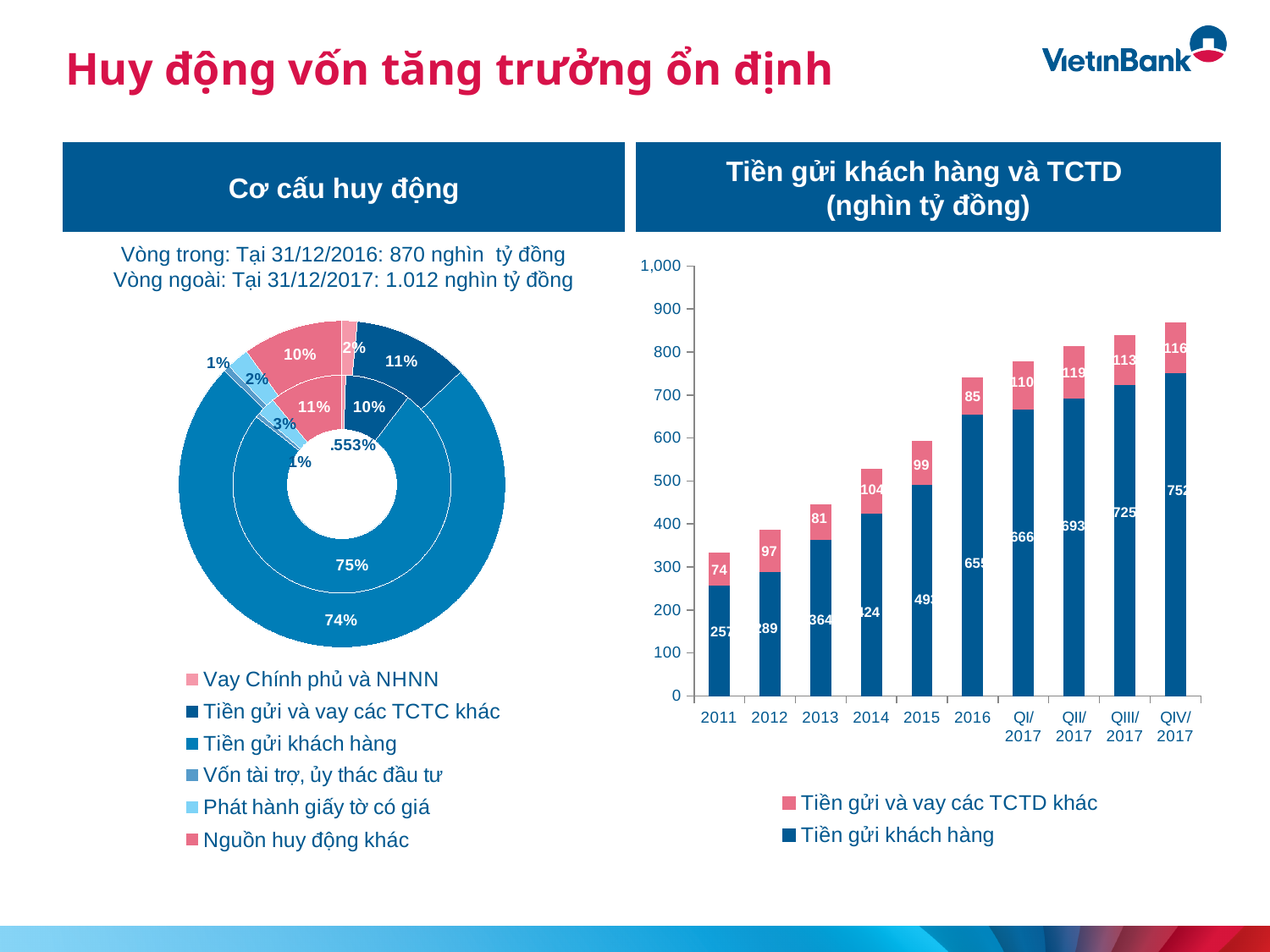
In the chart 'Tiền gửi khách hàng và TCTD (nghìn tỷ đồng)', which period has the highest value for Tiền gửi khách hàng? QIV/2017 In the chart 'Tiền gửi khách hàng và TCTD (nghìn tỷ đồng)', what is the total of the stacked bar for 2013? 445 How many periods are shown on the x axis of the chart 'Tiền gửi khách hàng và TCTD (nghìn tỷ đồng)'? 10 In the chart 'Tiền gửi khách hàng và TCTD (nghìn tỷ đồng)', which period has the lowest value for Tiền gửi khách hàng? 2011 In the chart 'Tiền gửi khách hàng và TCTD (nghìn tỷ đồng)', what is the value of Tiền gửi và vay các TCTD khác in QII/2017? 119 Does the value of Tiền gửi khách hàng in the chart 'Tiền gửi khách hàng và TCTD (nghìn tỷ đồng)' rise or fall from 2011 to QIV/2017? rise In the chart 'Tiền gửi khách hàng và TCTD (nghìn tỷ đồng)', what is the value of Tiền gửi khách hàng in 2014? 424 In the chart 'Tiền gửi khách hàng và TCTD (nghìn tỷ đồng)', which is larger for Tiền gửi và vay các TCTD khác: 2013 or 2014? 2014 How many series does the legend of the chart 'Tiền gửi khách hàng và TCTD (nghìn tỷ đồng)' list? 2 In the chart 'Cơ cấu huy động', what share does Tiền gửi khách hàng have in the outer ring (31/12/2017)? 74% In the chart 'Tiền gửi khách hàng và TCTD (nghìn tỷ đồng)', what is the difference between Tiền gửi khách hàng in 2016 and in 2015? 162 What kind of chart is 'Cơ cấu huy động'? doughnut chart